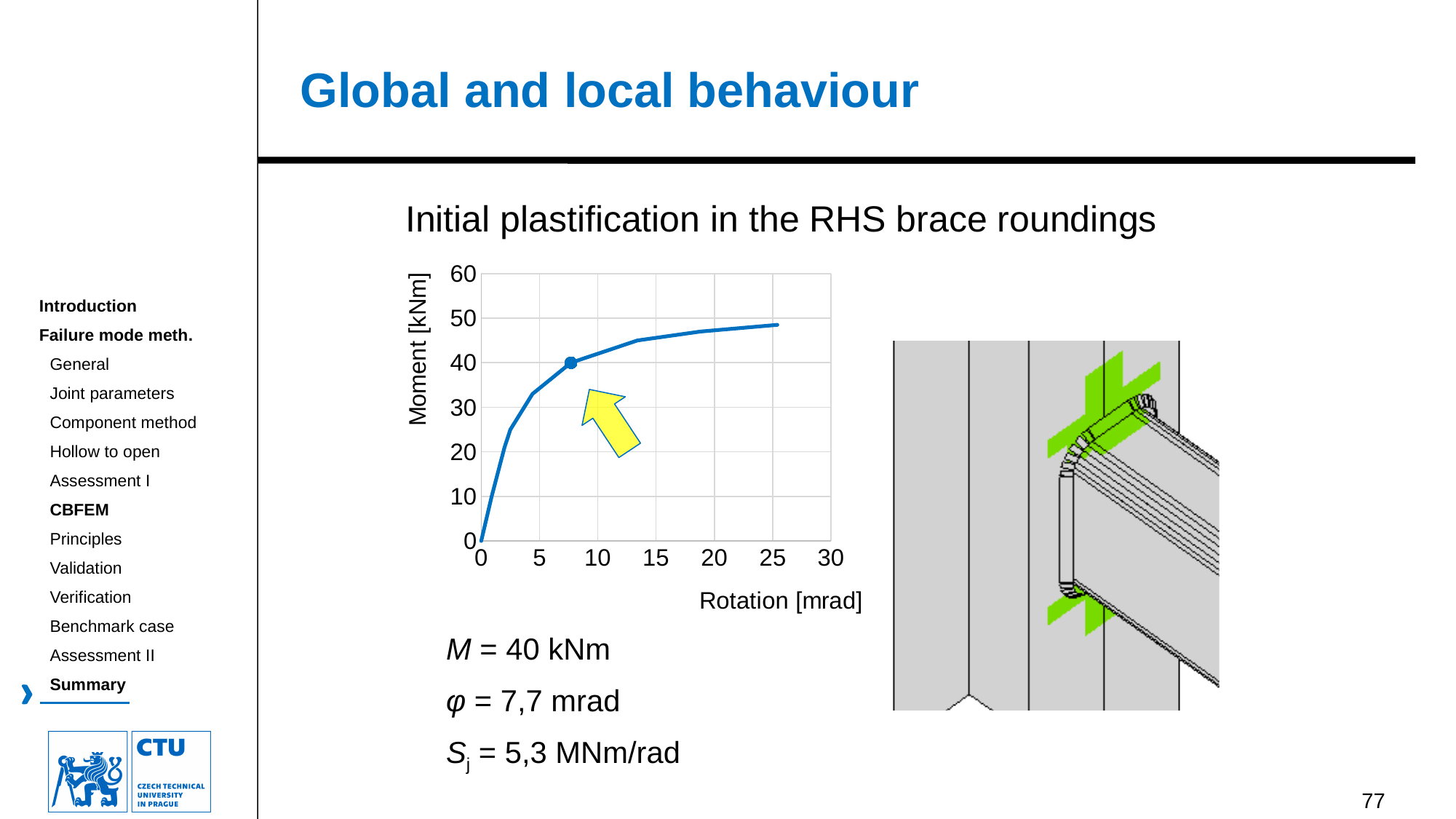
What is the highest value shown on the vertical axis of the chart? 60 What is the label of the vertical axis of the chart? Moment [kNm] What is the label of the horizontal axis of the chart? Rotation [mrad] What moment value corresponds to the marked point on the curve? 40 kNm Does the moment rise or fall as the rotation increases along the x axis? rise Is the moment at a rotation of 25 mrad greater or less than 50? less What kind of chart is shown on the slide? line chart Is the moment at a rotation of 25 mrad greater or less than 40? greater What rotation value corresponds to the marked point on the curve? 7,7 mrad Is the moment at a rotation of 15 mrad greater or less than 40? greater How many curves are plotted on the chart? 1